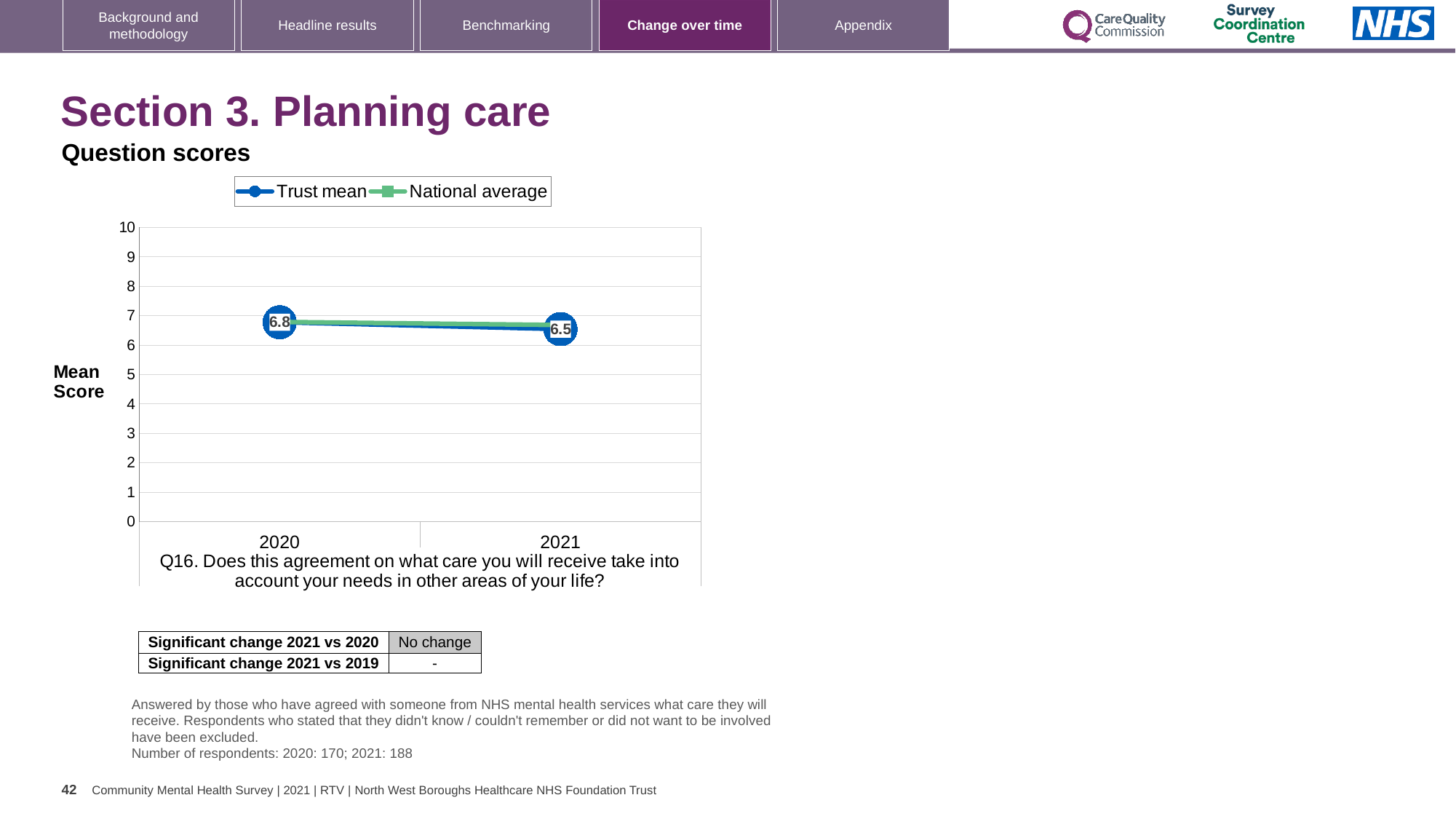
What kind of chart is shown on the slide? line chart By how much did the Trust mean score change from 2020 to 2021? 0.3 Does the Trust mean rise or fall from 2020 to 2021? fall Which year has the higher Trust mean score, 2020 or 2021? 2020 Is the National average value for 2021 greater or less than 5? greater How many series does the legend list? 2 What are the two series named in the legend? Trust mean and National average Is the National average value for 2020 greater or less than 8? less What is the label on the y axis of the chart? Mean Score How many years are plotted on the x axis? 2 What is the Trust mean score for 2021? 6.5 What is the Trust mean score for 2020? 6.8